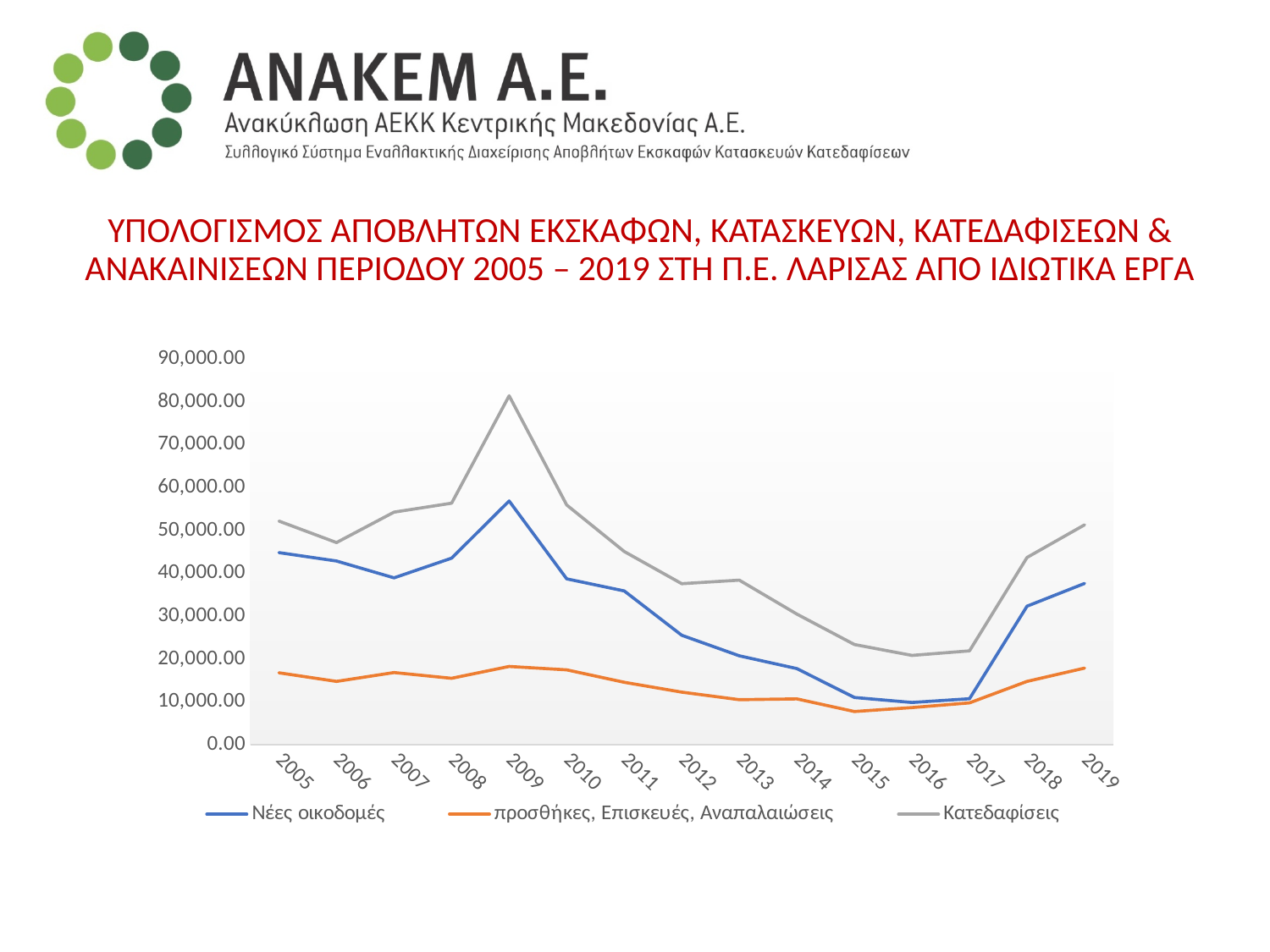
What kind of chart is shown on the slide? line chart In which year does the Κατεδαφίσεις series reach its highest value? 2009 In which year does the προσθήκες, Επισκευές, Αναπαλαιώσεις series reach its lowest value? 2015 Which series has the larger value in 2005, Νέες οικοδομές or προσθήκες, Επισκευές, Αναπαλαιώσεις? Νέες οικοδομές How many years are plotted along the x axis? 15 Is the value for προσθήκες, Επισκευές, Αναπαλαιώσεις in 2015 greater or less than 10,000.00? less In which year does the Νέες οικοδομές series reach its highest value? 2009 Does the Νέες οικοδομές series rise or fall from 2009 to 2016? fall Is the value for Νέες οικοδομές in 2019 greater or less than 40,000.00? less Is the value for Κατεδαφίσεις in 2009 greater or less than 70,000.00? greater Which series is drawn in orange? προσθήκες, Επισκευές, Αναπαλαιώσεις How many series does the legend list? 3